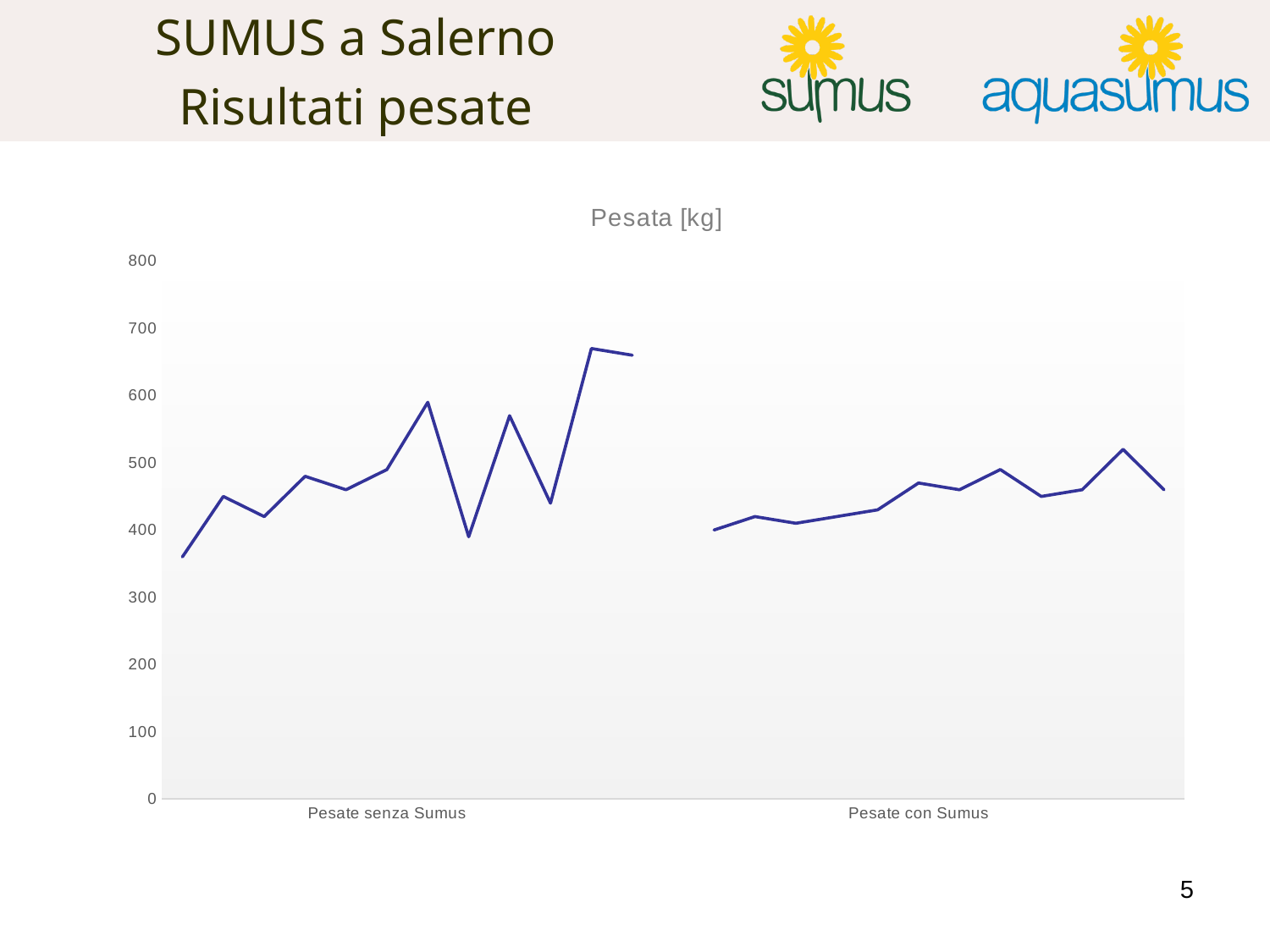
What is the maximum value shown on the y axis? 800 Which group contains the lowest plotted value, Pesate senza Sumus or Pesate con Sumus? Pesate senza Sumus Is the lowest value in the Pesate con Sumus group greater or less than 300? greater How many groups of weighings are shown along the x axis? 2 Which group reaches the higher peak value, Pesate senza Sumus or Pesate con Sumus? Pesate senza Sumus Is the highest value in the Pesate senza Sumus group greater or less than 600? greater What is the title of the chart? Pesata [kg] Is the highest value in the Pesate con Sumus group greater or less than 600? less What kind of chart is shown on the slide? line chart What are the two category labels shown on the x axis of the chart? Pesate senza Sumus, Pesate con Sumus How many data points are plotted in the Pesate senza Sumus group? 12